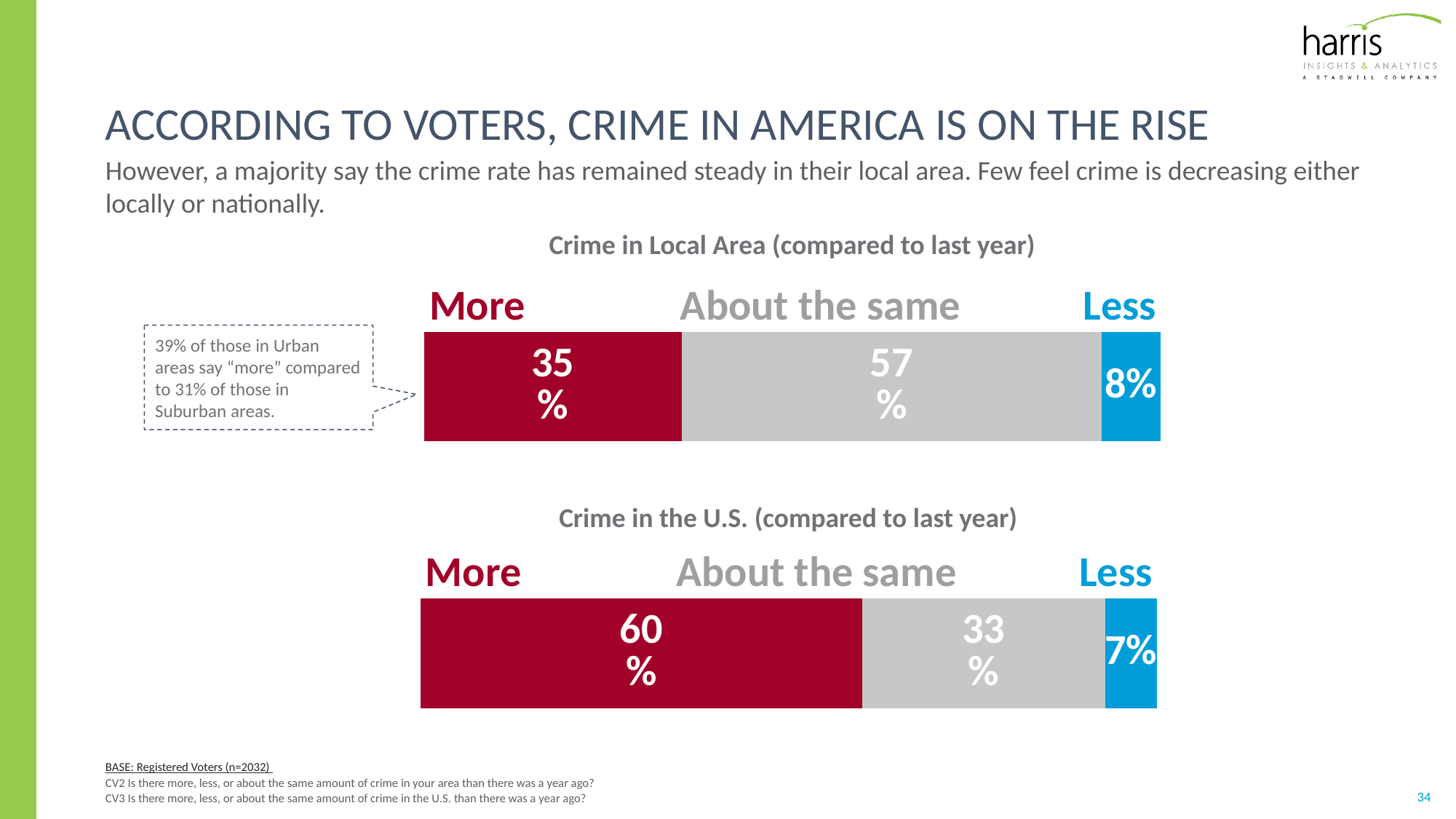
In the 'Crime in the U.S. (compared to last year)' chart, what percentage say 'Less'? 7% In the 'Crime in Local Area (compared to last year)' chart, what percentage say 'About the same'? 57% How many response categories are shown in the 'Crime in the U.S. (compared to last year)' chart? 3 What type of chart is used for 'Crime in Local Area (compared to last year)'? Stacked bar chart Which is larger: the 'About the same' share in the 'Crime in Local Area' chart or the 'About the same' share in the 'Crime in the U.S.' chart? Crime in Local Area What is the difference between the 'More' percentage in the 'Crime in the U.S.' chart and the 'More' percentage in the 'Crime in Local Area' chart? 25% In the 'Crime in Local Area (compared to last year)' chart, what percentage say 'More'? 35% In the 'Crime in the U.S. (compared to last year)' chart, which response has the smallest share? Less In the 'Crime in Local Area (compared to last year)' chart, which response has the largest share? About the same In the 'Crime in the U.S. (compared to last year)' chart, what percentage say 'About the same'? 33% In the 'Crime in the U.S. (compared to last year)' chart, what percentage say 'More'? 60% In the 'Crime in Local Area (compared to last year)' chart, what percentage say 'Less'? 8%